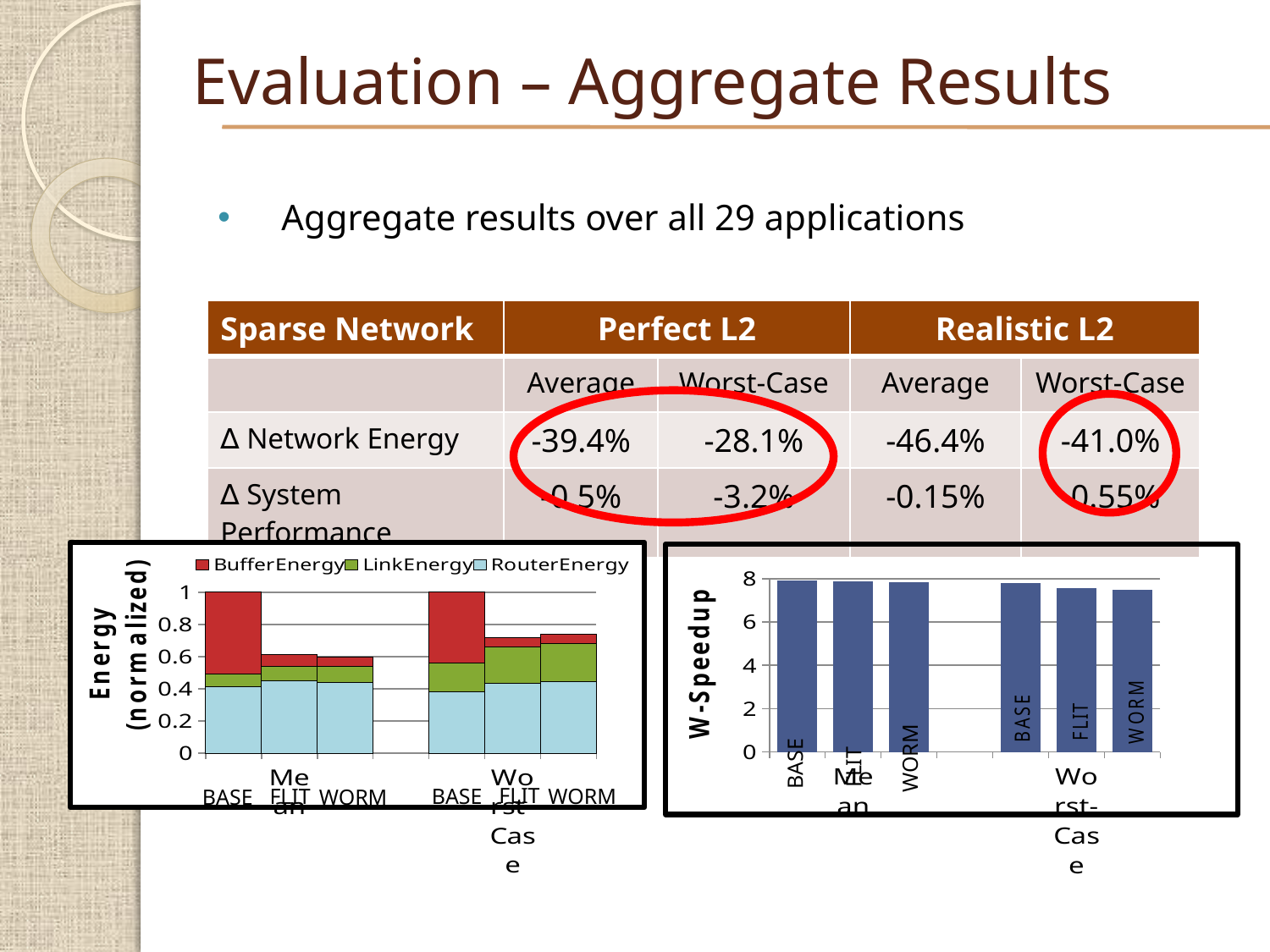
How many bars are plotted in the W-Speedup chart? 6 What kind of chart is the W-Speedup chart on the right? bar chart In the Energy (normalized) chart, is the total energy for FLIT in the Mean group greater or less than 0.8? less In the Energy (normalized) chart, which has the larger total energy in the Mean group, BASE or FLIT? BASE In the W-Speedup chart, is the value for BASE in the Mean group greater or less than 6? greater How many bars are plotted in the Energy (normalized) chart? 6 Which series are listed in the legend of the Energy (normalized) chart? BufferEnergy, LinkEnergy, RouterEnergy In the Energy (normalized) chart, is the total energy for WORM in the Worst-Case group greater or less than 0.8? less What kind of chart is the Energy (normalized) chart on the left? stacked bar chart How many series does the legend of the Energy (normalized) chart list? 3 What is the y-axis title of the chart on the right? W-Speedup